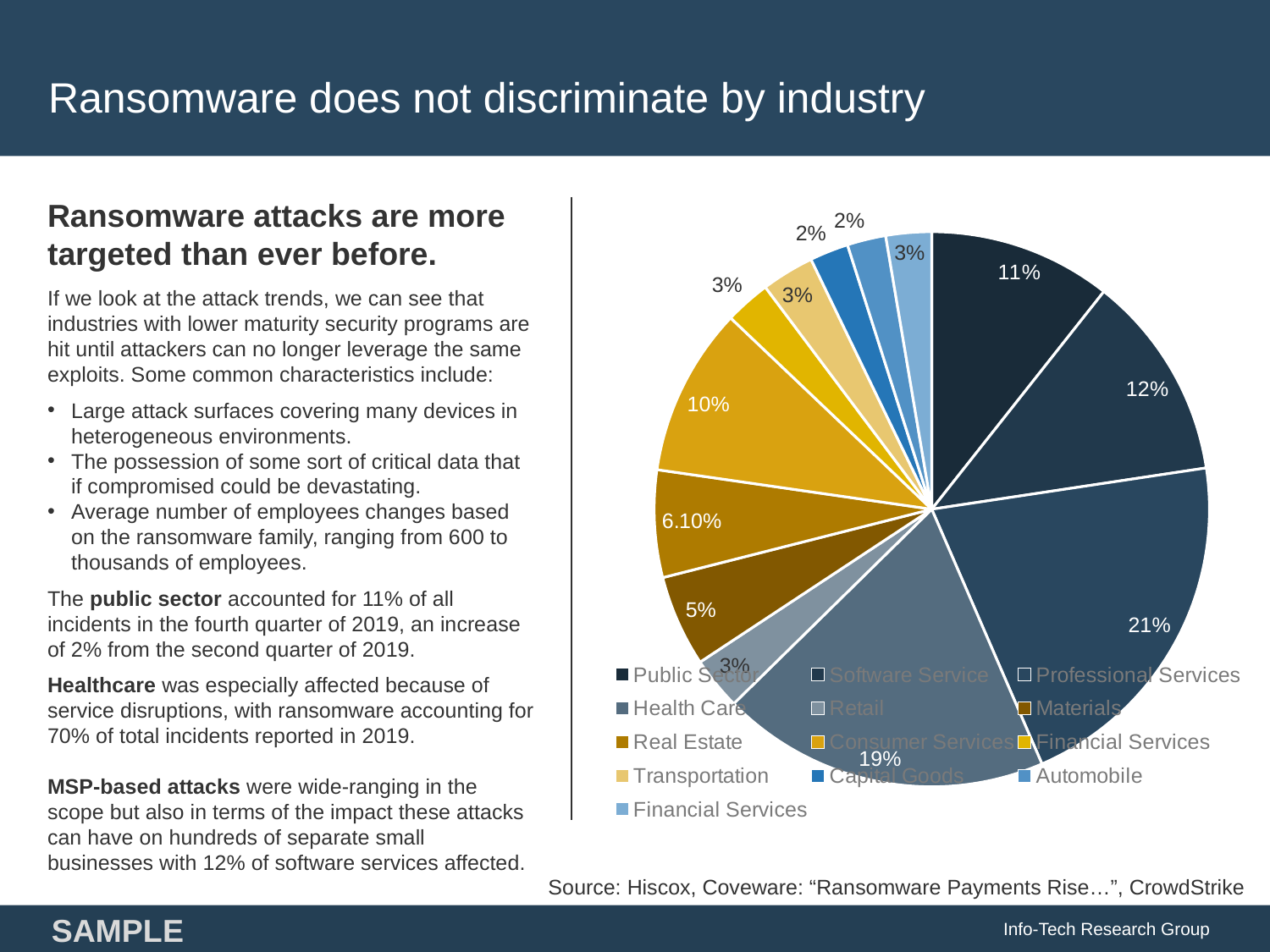
What is the value shown for the Software Service slice? 12% What is the value shown for the Health Care slice? 19% What is the value shown for the Professional Services slice? 21% Which is larger, the Public Sector slice or the Software Service slice? Software Service What is the value shown for the Real Estate slice? 6.10% How many slices does the pie chart have? 13 Which category has the largest slice of the pie? Professional Services What percentage of the pie does the Public Sector slice represent? 11% How many entries does the chart legend list? 13 What type of chart is shown on the slide? pie chart What is the difference between the Professional Services slice and the Health Care slice? 2% What is the title of the slide containing the pie chart? Ransomware does not discriminate by industry